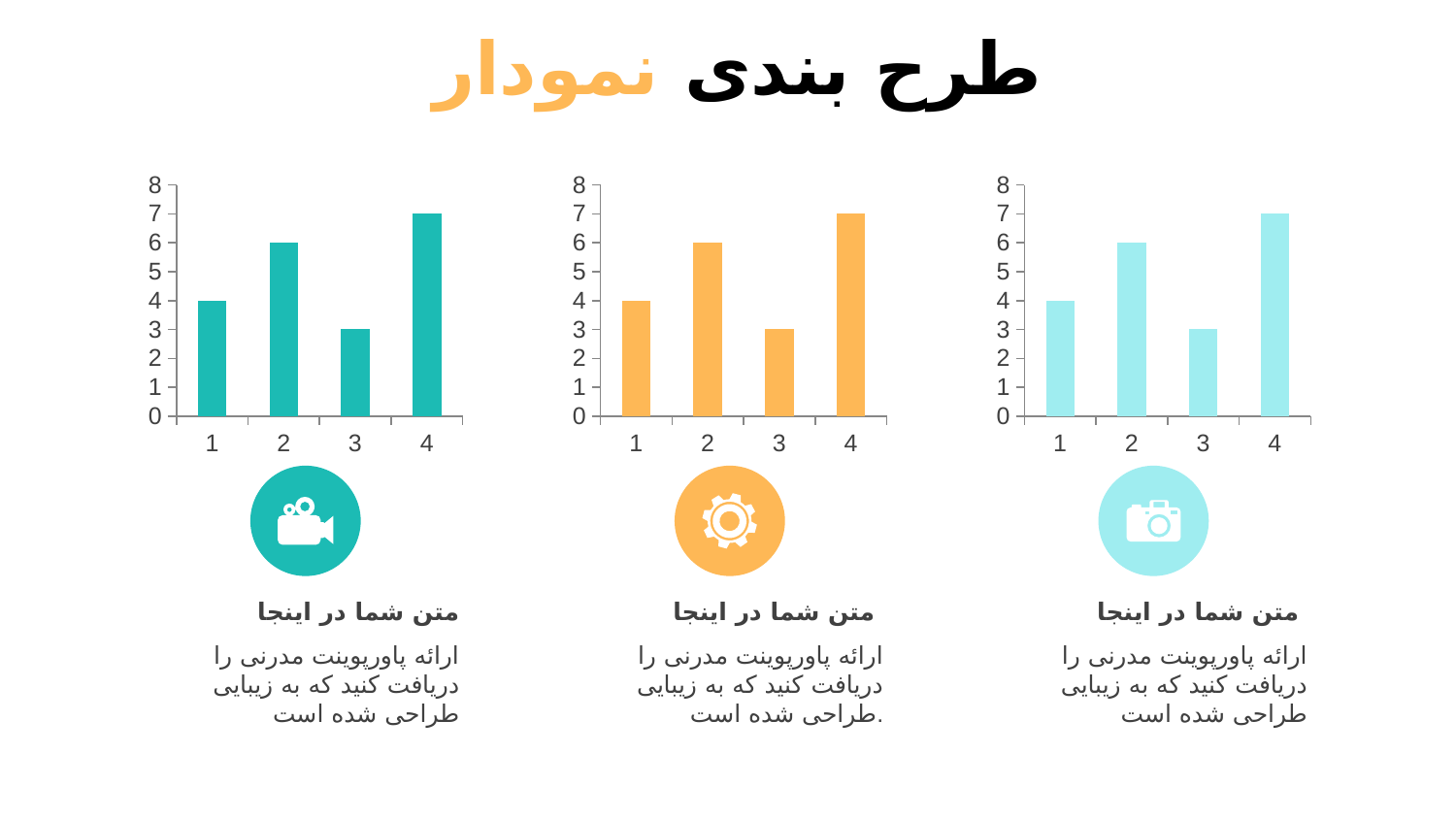
On the right chart, what is the difference between the values for category 4 and category 1? 3 On the middle chart, which category has the lowest value? 3 How many charts are on the slide? 3 On the middle chart, is the value for category 2 greater or less than 5? greater What kind of chart is the left chart? bar chart What colour are the bars in the middle chart? orange On the left chart, which category has the highest value? 4 On the middle chart, what is the value for category 4? 7 On the right chart, what is the value for category 3? 3 On the left chart, which is larger, the value for category 2 or category 3? category 2 How many categories are shown on the right chart? 4 On the left chart, what is the value for category 1? 4